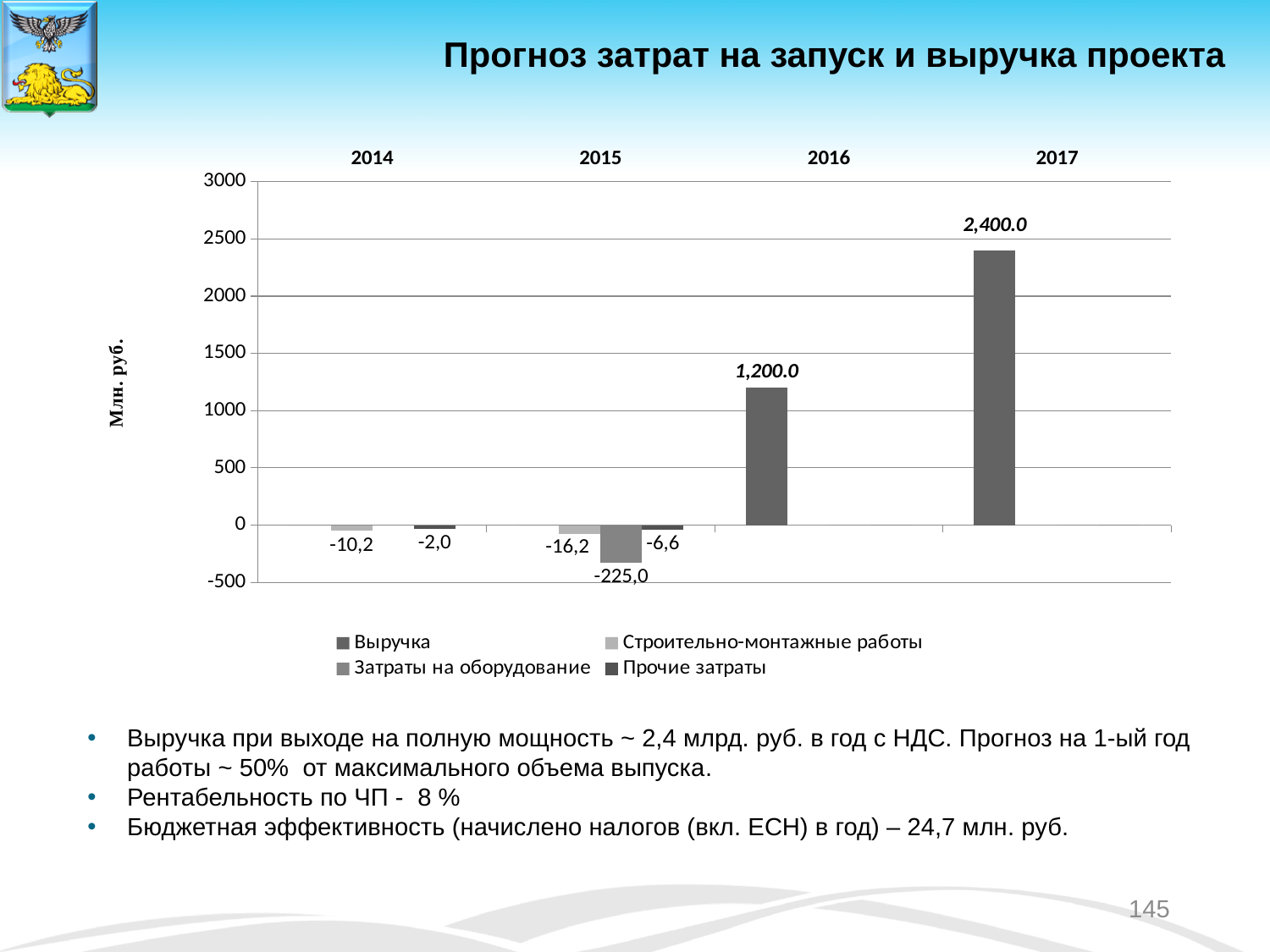
What is the value of Прочие затраты in 2015? -6,6 Which is larger in absolute value: Строительно-монтажные работы in 2015 or in 2014? 2015 What is the difference between Выручка in 2017 and in 2016? 1,200.0 What is the value of Затраты на оборудование in 2015? -225,0 What is the label of the vertical axis? Млн. руб. How many series does the legend list? 4 What is the value of Выручка in 2016? 1,200.0 How many years are shown on the x axis? 4 What is the value of Строительно-монтажные работы in 2014? -10,2 What is the value of Выручка in 2017? 2,400.0 What type of chart is shown on the slide? bar chart In which year is Выручка highest? 2017